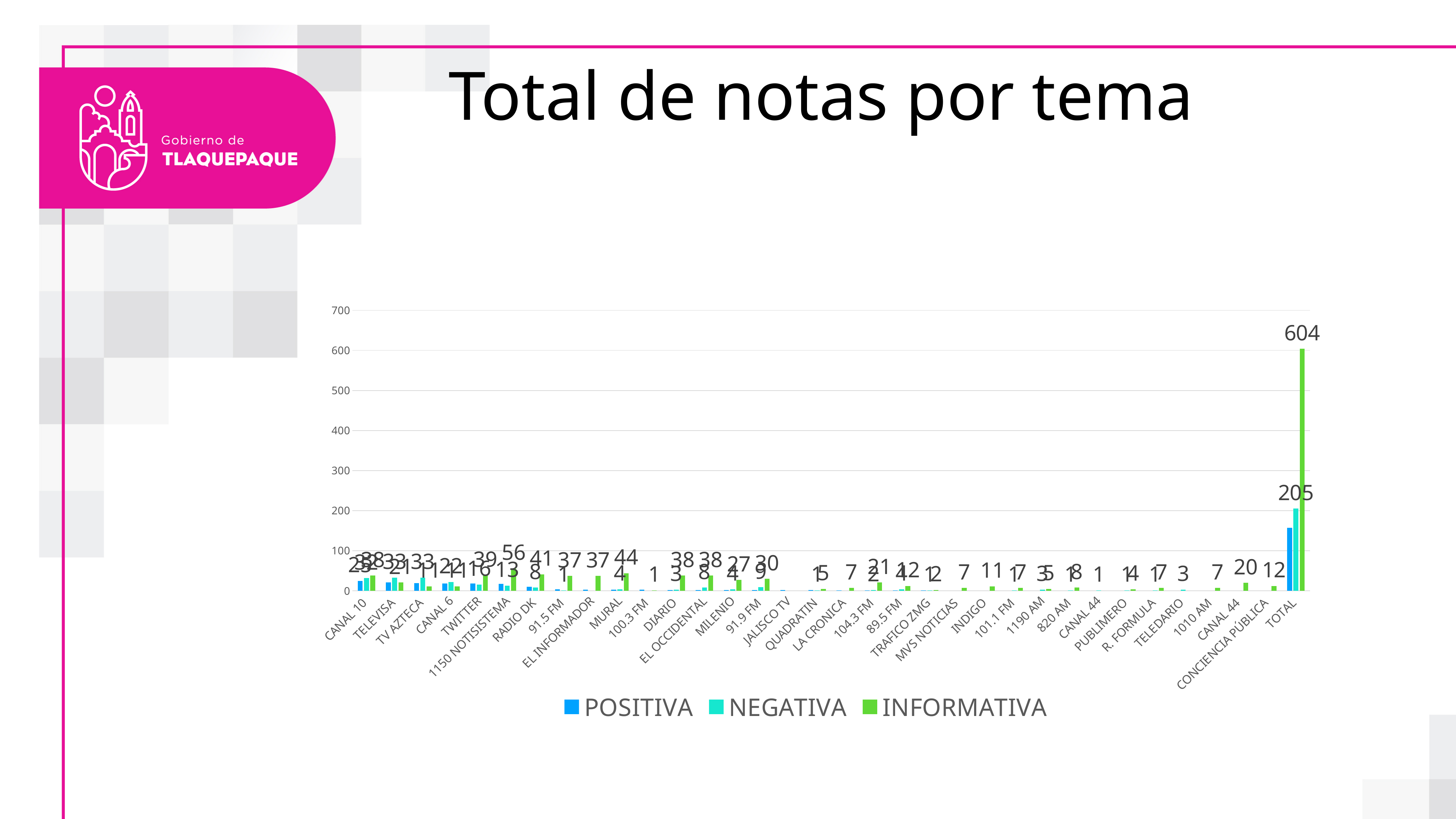
Which category has the highest INFORMATIVA value? TOTAL How many series does the legend list? 3 For TOTAL, which is larger: the INFORMATIVA value or the NEGATIVA value? INFORMATIVA Is the POSITIVA value for TOTAL greater or less than 100? greater What is the INFORMATIVA value for 1150 NOTISISTEMA? 56 What are the three series listed in the legend? POSITIVA, NEGATIVA, INFORMATIVA What is the NEGATIVA value for TOTAL? 205 Is the POSITIVA value for TOTAL greater or less than 200? less What is the INFORMATIVA value for TOTAL? 604 What is the difference between the INFORMATIVA and NEGATIVA values for TOTAL? 399 What is the title of the slide? Total de notas por tema What kind of chart is shown on the slide? bar chart